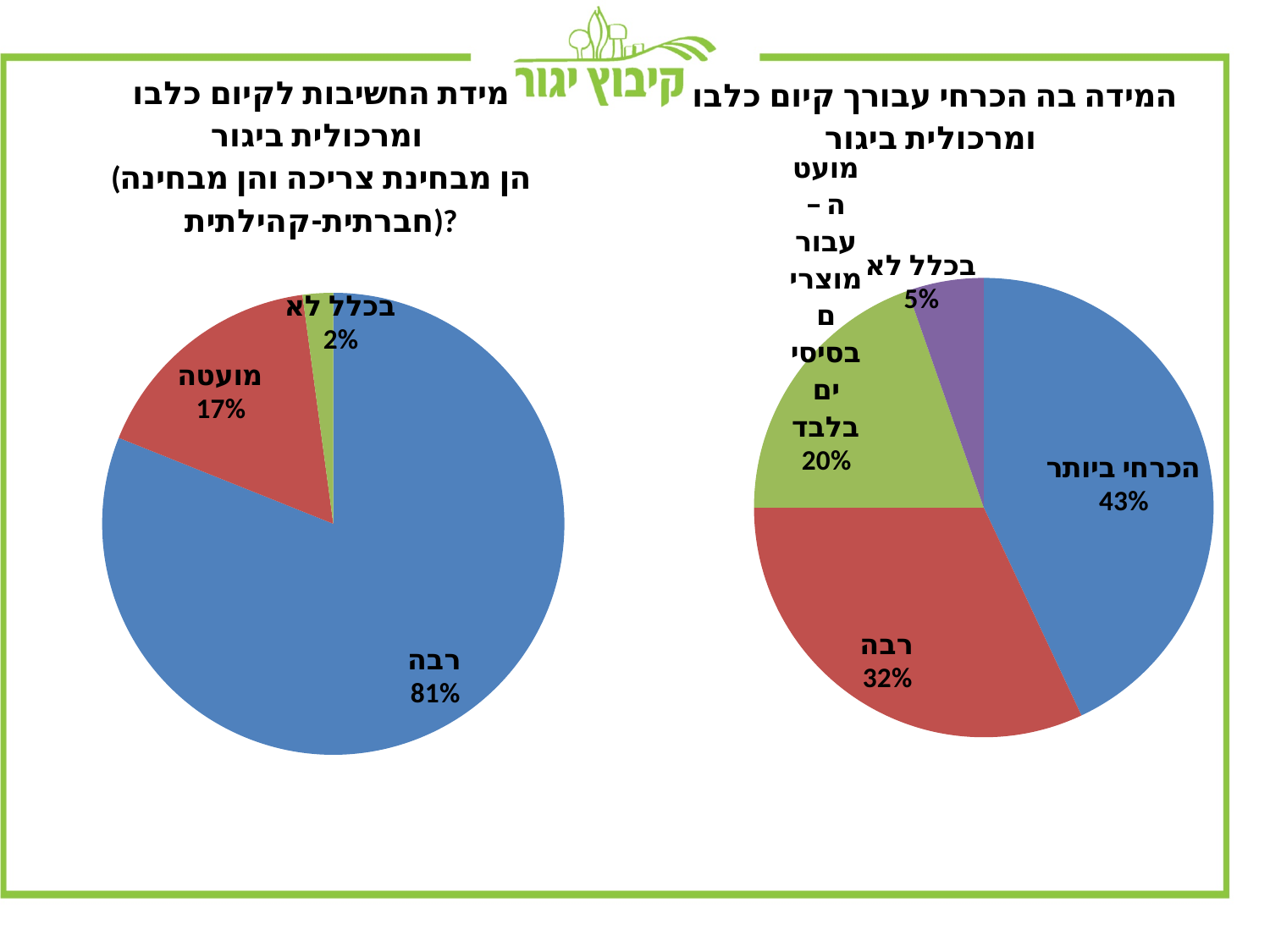
In the right-hand pie chart, what percentage is shown for רבה? 32% In the right-hand pie chart, which category has the largest slice? הכרחי ביותר In the right-hand pie chart, which category has the smallest slice? בכלל לא In the right-hand pie chart, what is the difference in percentage points between הכרחי ביותר and רבה? 11 In the left-hand pie chart (מידת החשיבות לקיום כלבו ומרכולית ביגור), what percentage is shown for רבה? 81% In the left-hand pie chart, what is the difference in percentage points between רבה and מועטה? 64 How many slices does the right-hand pie chart have? 4 In the left-hand pie chart, which category has the smallest slice? בכלל לא In the left-hand pie chart, what percentage is shown for מועטה? 17% In the right-hand pie chart, what percentage is shown for בכלל לא? 5% What type of chart is the left-hand chart on the slide? Pie chart In the right-hand pie chart (המידה בה הכרחי עבורך קיום כלבו ומרכולית ביגור), what percentage is shown for הכרחי ביותר? 43%